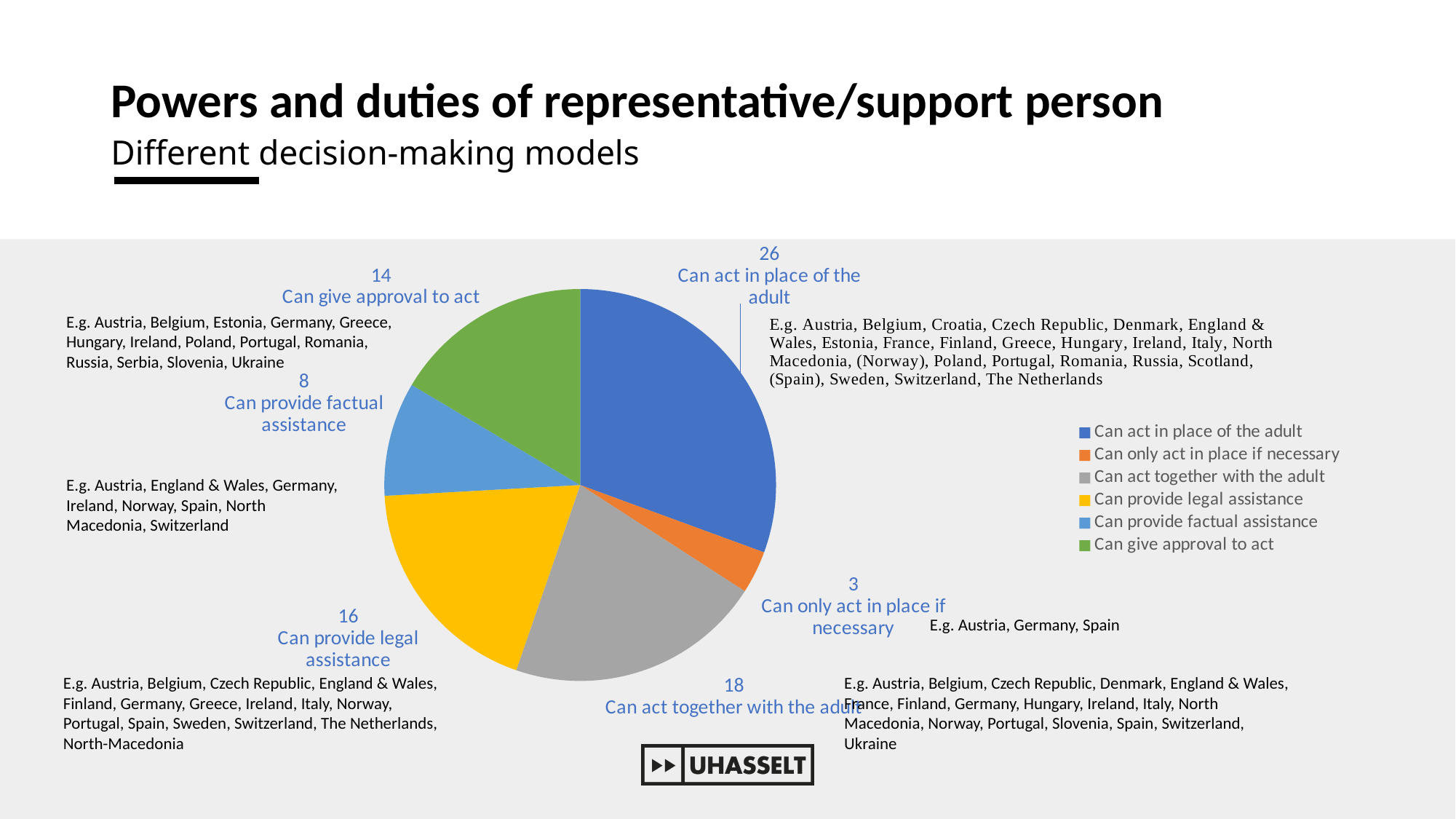
What is the total of all the values shown in the pie chart? 85 What is the difference between the values for "Can provide legal assistance" and "Can give approval to act"? 2 What is the value for "Can act together with the adult"? 18 Which category has the largest slice of the pie? Can act in place of the adult Which category has the smallest slice of the pie? Can only act in place if necessary How many categories does the pie chart show? 6 What is the value for "Can act in place of the adult"? 26 What is the value for "Can provide factual assistance"? 8 What kind of chart is shown on the slide? Pie chart Which is larger: "Can provide legal assistance" or "Can give approval to act"? Can provide legal assistance What is the difference between the values for "Can act in place of the adult" and "Can act together with the adult"? 8 What is the value for "Can only act in place if necessary"? 3